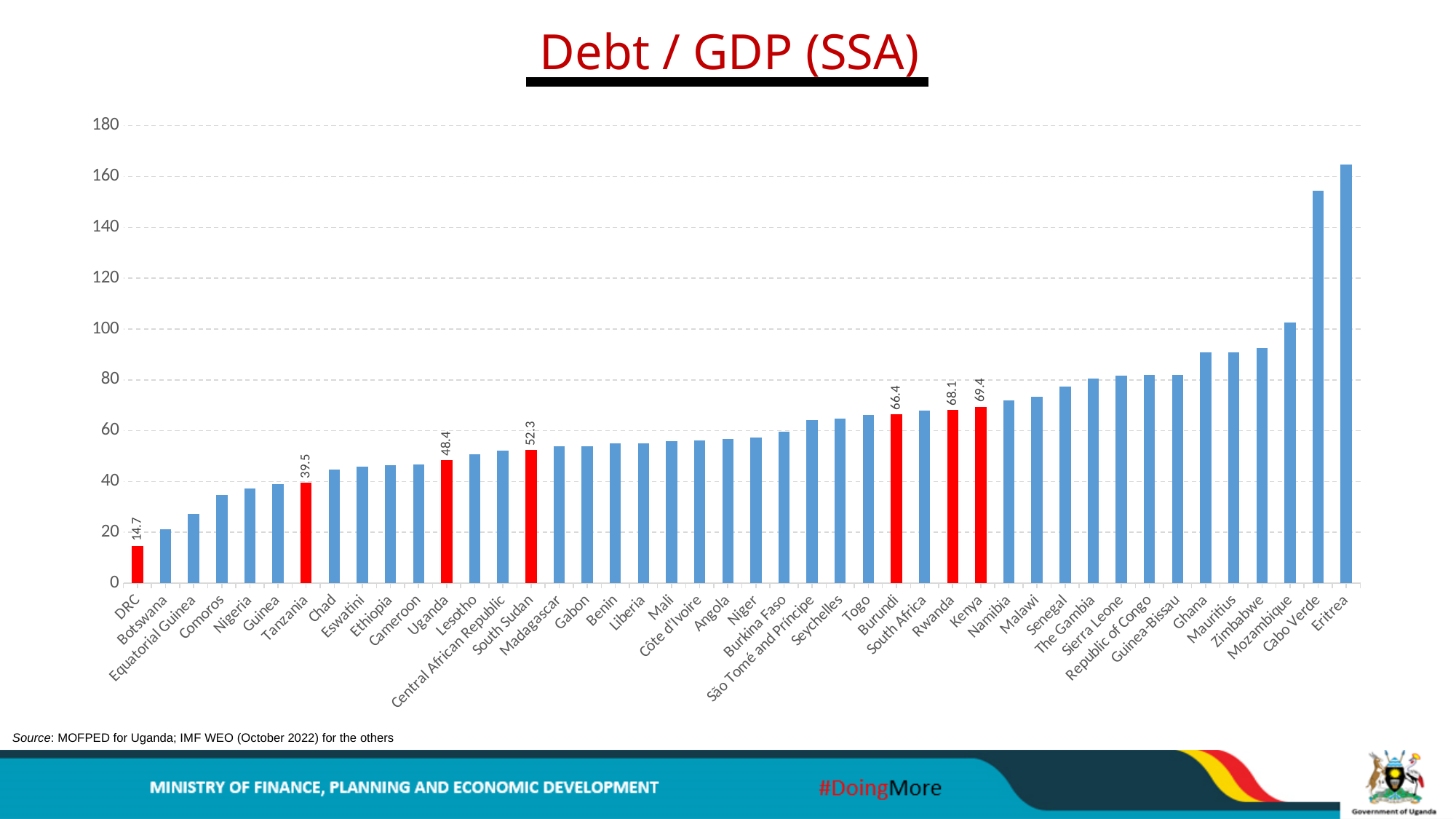
Is the Debt / GDP value for Cabo Verde greater or less than 140? greater What is the Debt / GDP value for Kenya? 69.4 What type of chart is shown on the slide? Bar chart Which country has the highest Debt / GDP ratio on the chart? Eritrea What is the difference between Kenya's and Uganda's Debt / GDP values? 21.0 Which has a higher Debt / GDP ratio, Rwanda or Burundi? Rwanda Which country has the lowest Debt / GDP ratio on the chart? DRC Is the Debt / GDP value for Mozambique greater or less than 100? greater Do the Debt / GDP values rise or fall moving from left to right along the x axis? Rise What is the Debt / GDP value for Uganda? 48.4 What is the Debt / GDP value for DRC? 14.7 How many bars are highlighted in red on the chart? 7